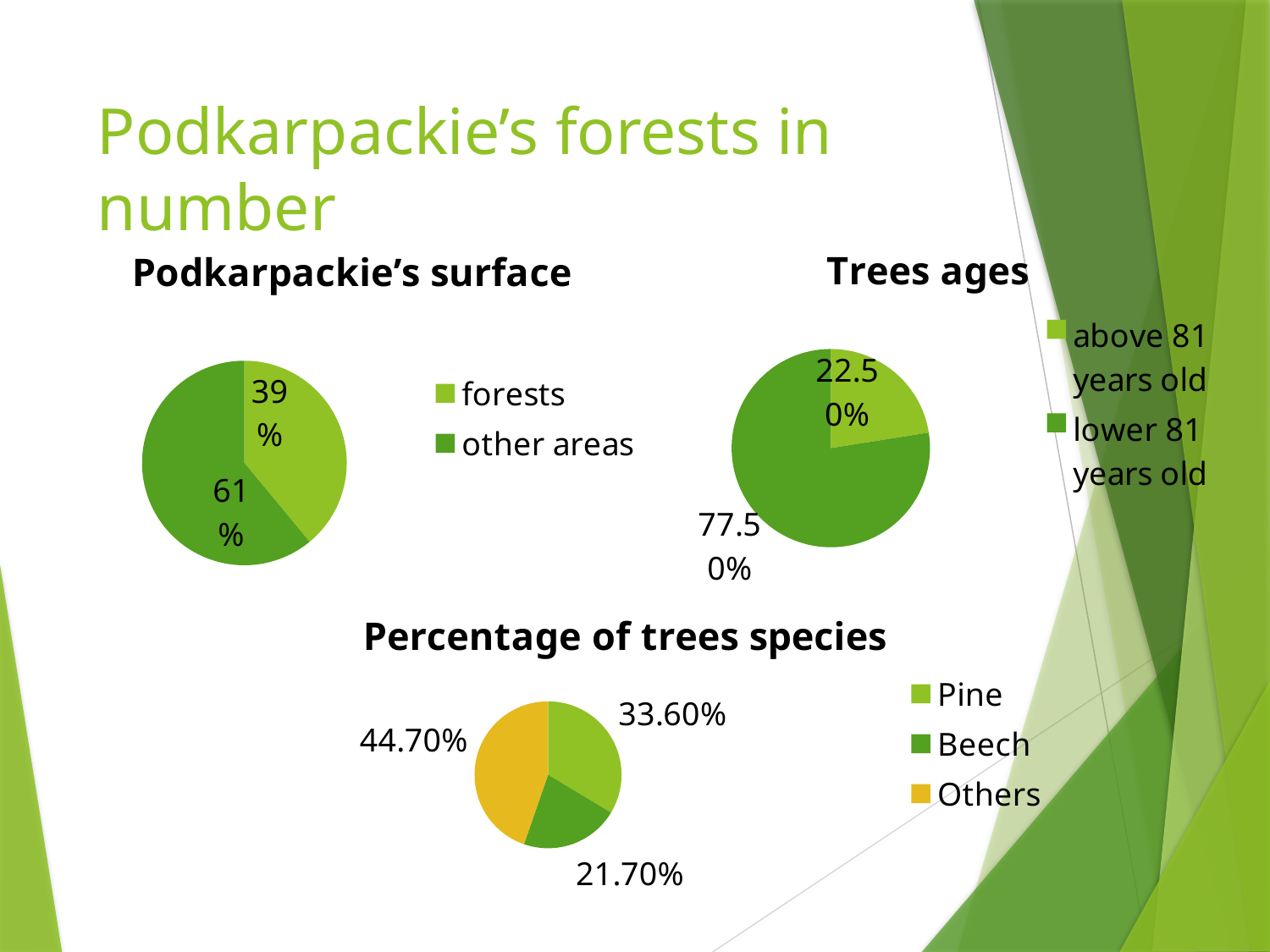
In the 'Percentage of trees species' chart, what percentage is shown for Beech? 21.70% In the 'Podkarpackie's surface' chart, which slice is larger, forests or other areas? other areas What type of chart is the 'Percentage of trees species' chart? pie chart In the 'Podkarpackie's surface' chart, what percentage is shown for forests? 39% In the 'Percentage of trees species' chart, which species category has the largest share? Others In the 'Percentage of trees species' chart, which species category has the smallest share? Beech In the 'Trees ages' chart, how many categories does the legend list? 2 In the 'Percentage of trees species' chart, what is the difference between the Others share and the Pine share? 11.10% In the 'Trees ages' chart, what percentage of trees are above 81 years old? 22.50% In the 'Trees ages' chart, what percentage of trees are lower than 81 years old? 77.50% In the 'Podkarpackie's surface' chart, what percentage is shown for other areas? 61% In the 'Percentage of trees species' chart, what percentage is shown for Pine? 33.60%